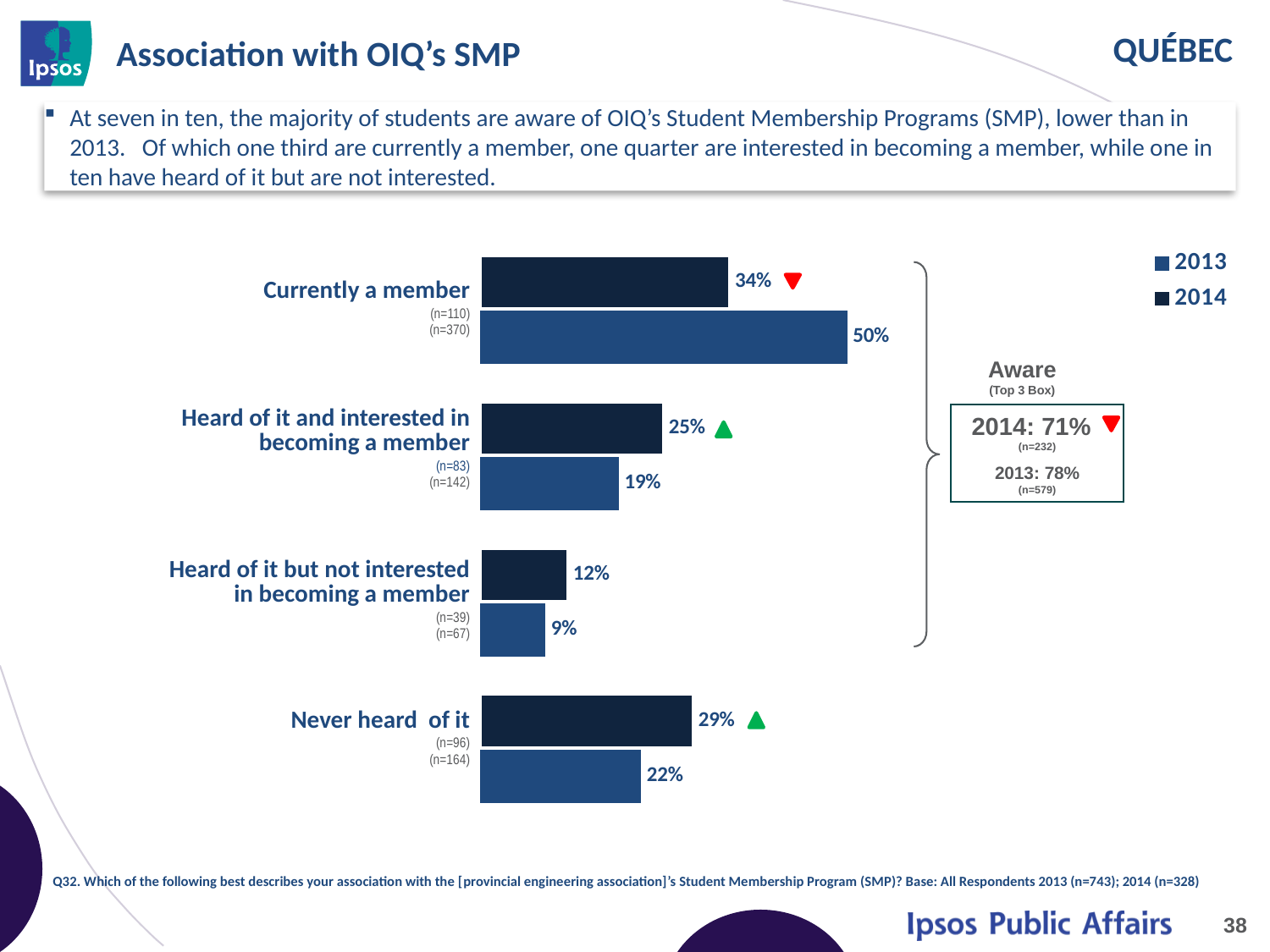
What is the value of the upper (dark navy) bar for 'Never heard of it'? 29% What is the value of the lower (lighter blue) bar for 'Heard of it but not interested in becoming a member'? 9% How many categories are plotted in the chart? 4 What is the value of the lower (lighter blue) bar for 'Currently a member'? 50% Which category has the single highest bar value in the chart? Currently a member What type of chart is shown on the slide? Bar chart How many series does the chart legend list? 2 What is the value of the upper (dark navy) bar for 'Currently a member'? 34% What is the difference between the two bars for 'Currently a member'? 16 percentage points What is the difference between the two bars for 'Never heard of it'? 7 percentage points What are the two entries in the chart legend? 2013 and 2014 For 'Heard of it and interested in becoming a member', which bar is larger, the upper (dark navy) bar or the lower (lighter blue) bar? The upper (dark navy) bar